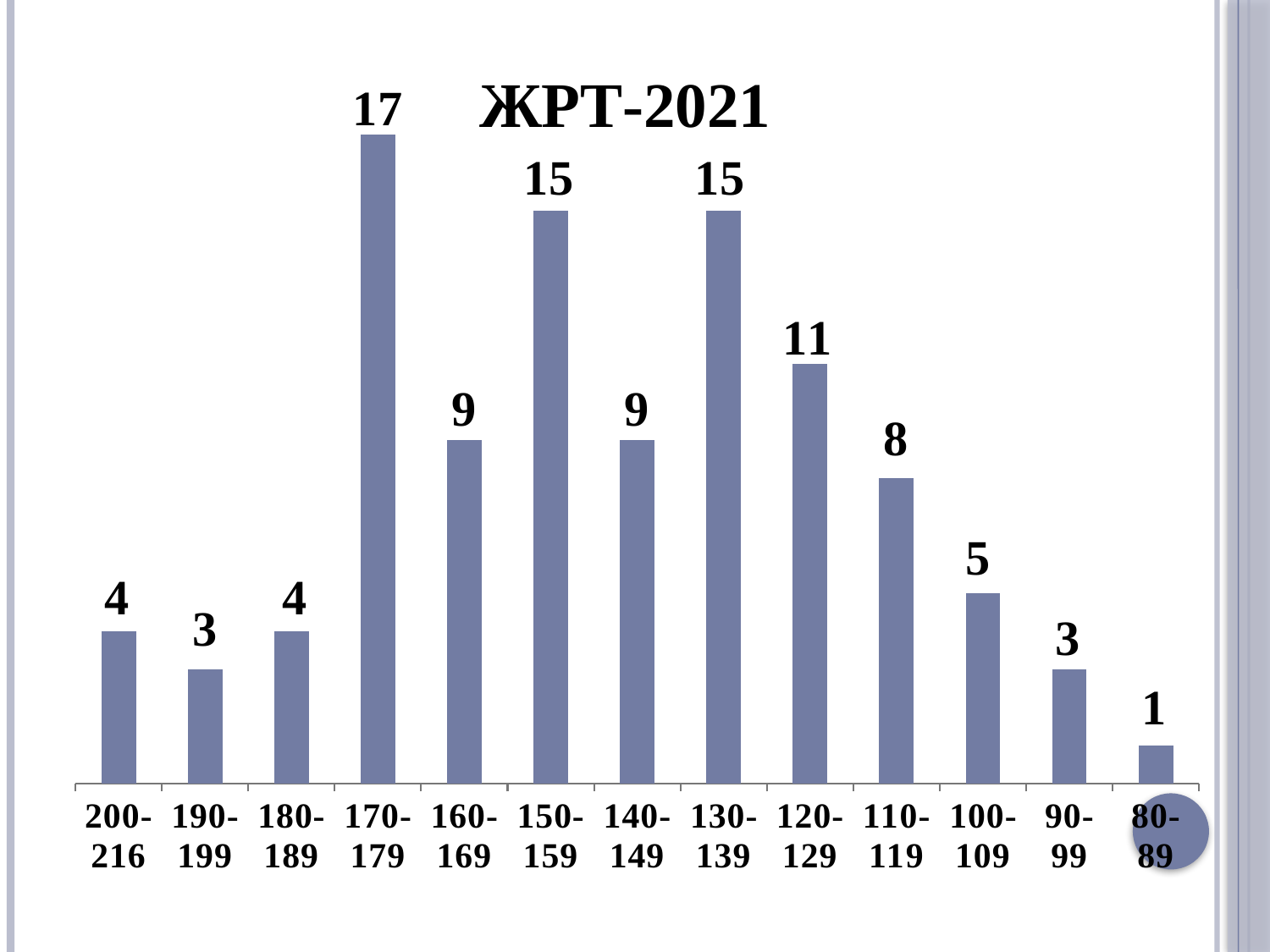
What is the value for the 120-129 category? 11 What is the difference between the values for 170-179 and 150-159? 2 What is the title of the chart? ЖРТ-2021 Which is larger, the value for 160-169 or the value for 100-109? 160-169 What is the difference between the values for 120-129 and 110-119? 3 What is the value for the 80-89 category? 1 What is the value for the 170-179 category? 17 What kind of chart is this? bar chart Which category has the lowest value? 80-89 How many categories are shown on the x axis? 13 Which category has the highest value? 170-179 What is the value for the 90-99 category? 3